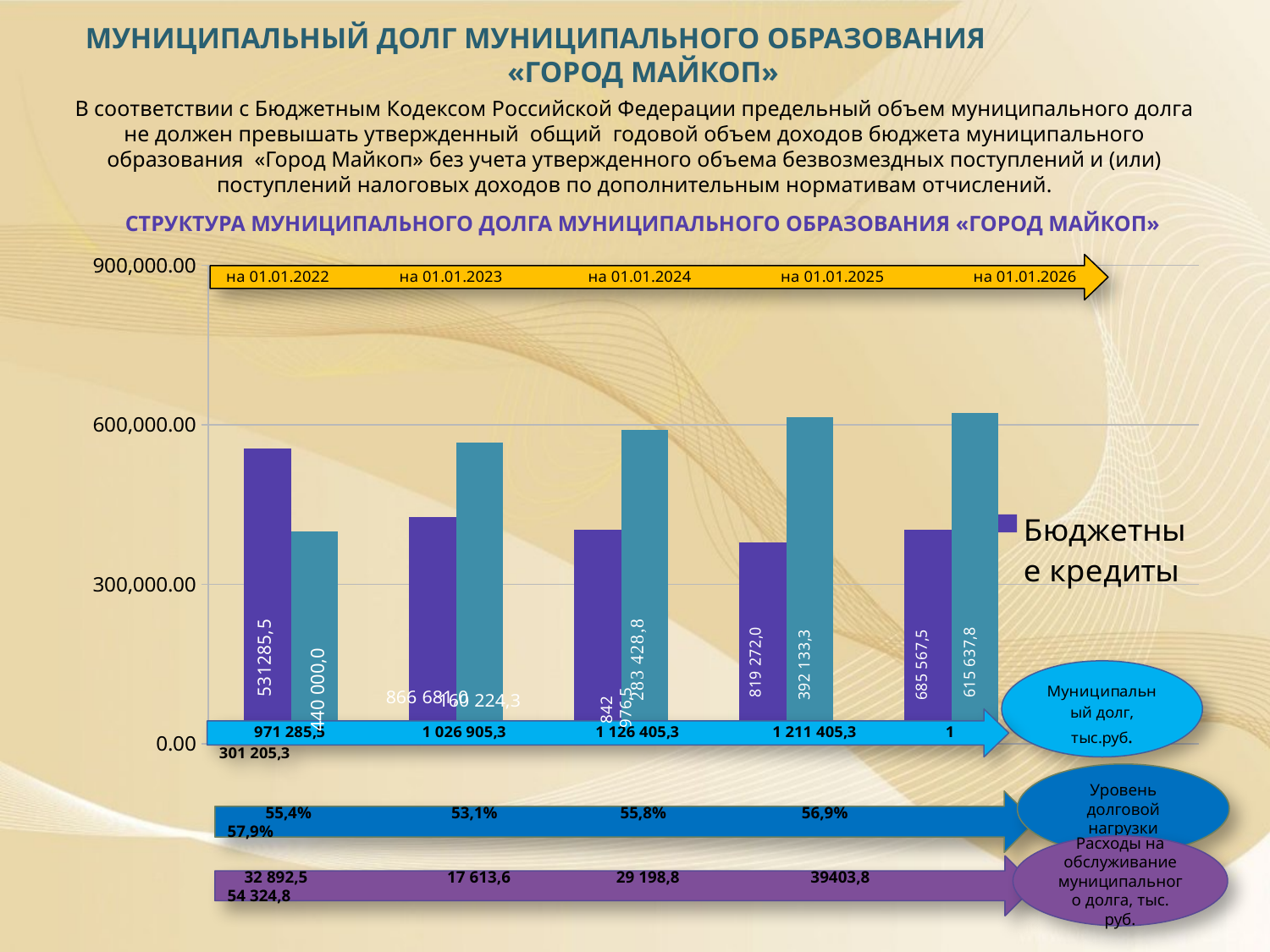
At which date is the purple bar the tallest? на 01.01.2022 For на 01.01.2026, which bar is taller, the purple one or the teal one? teal Is the teal bar for на 01.01.2026 greater or less than 600,000.00? greater For на 01.01.2022, which bar is taller, the purple one or the teal one? purple Do the teal bars rise or fall from на 01.01.2022 to на 01.01.2026? rise What kind of chart is shown on the slide? bar chart What is the data label on the teal bar for на 01.01.2026? 615 637,8 What legend entry is shown to the right of the chart? Бюджетные кредиты What is the difference between the purple and teal bar labels for на 01.01.2022? 91 285,5 What is the data label on the purple bar for на 01.01.2022? 531285,5 What is the data label on the teal bar for на 01.01.2022? 440 000,0 How many dates (categories) are shown along the x axis of the chart? 5